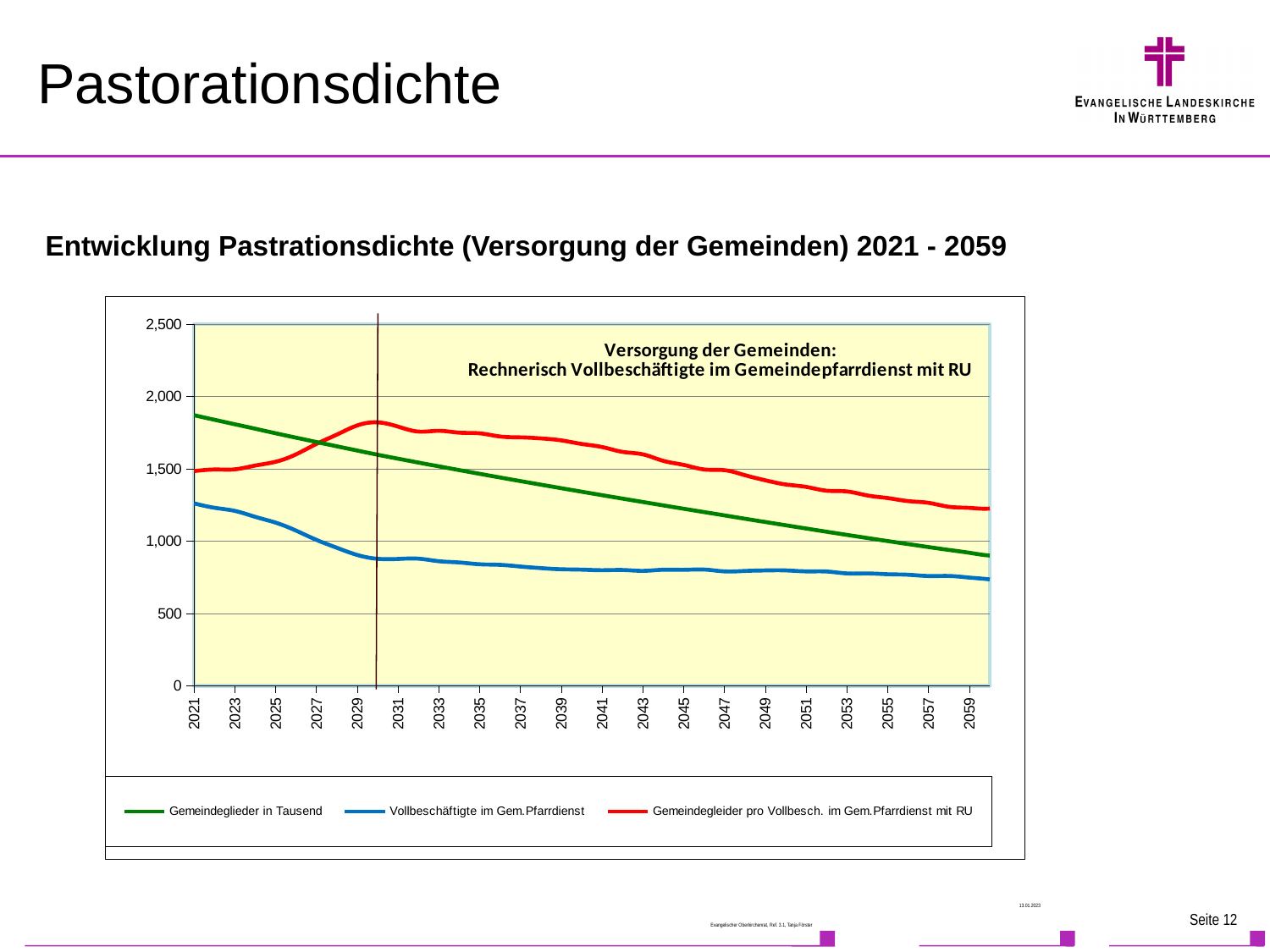
What kind of chart is shown on the slide? line chart Is the value of Gemeindeglieder in Tausend in 2021 greater or less than 1,500? greater Is the value of Gemeindegleider pro Vollbesch. im Gem.Pfarrdienst mit RU in 2031 greater or less than 1,500? greater Is the value of Vollbeschäftigte im Gem.Pfarrdienst in 2059 greater or less than 1,000? less Does the red line (Gemeindegleider pro Vollbesch. im Gem.Pfarrdienst mit RU) rise or fall between 2031 and 2059? fall What colour is the line for Vollbeschäftigte im Gem.Pfarrdienst? blue How many series does the legend list? 3 Does the green line (Gemeindeglieder in Tausend) rise or fall from 2021 to 2059? fall In 2059, which is higher: the red line (Gemeindegleider pro Vollbesch. im Gem.Pfarrdienst mit RU) or the blue line (Vollbeschäftigte im Gem.Pfarrdienst)? Gemeindegleider pro Vollbesch. im Gem.Pfarrdienst mit RU Does the blue line (Vollbeschäftigte im Gem.Pfarrdienst) rise or fall from 2021 to 2059? fall In 2021, which is higher: the green line (Gemeindeglieder in Tausend) or the red line (Gemeindegleider pro Vollbesch. im Gem.Pfarrdienst mit RU)? Gemeindeglieder in Tausend